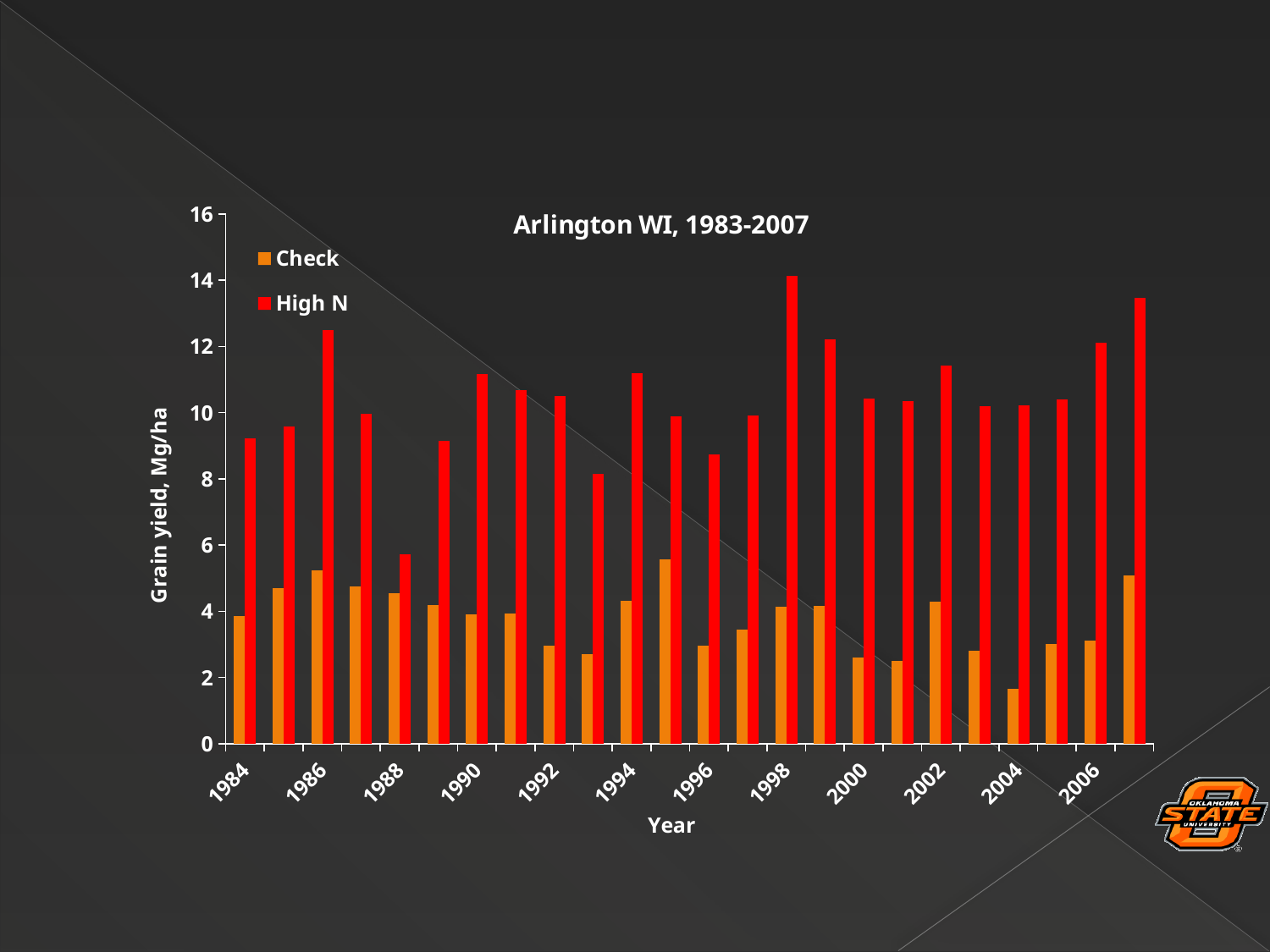
What is the label on the vertical axis? Grain yield, Mg/ha Is the Check value for 2004 greater or less than 2? less In which year is the High N bar the shortest? 1988 Which is larger, the Check value for 1986 or the Check value for 2004? 1986 How many series does the legend list? 2 Which is larger, the High N value for 1986 or the High N value for 1988? 1986 In which year is the Check bar the shortest? 2004 Is the High N value for 1998 greater or less than 12? greater Is the High N value for 1988 greater or less than 6? less What is the title of the chart? Arlington WI, 1983-2007 In which year is the High N bar the tallest? 1998 What kind of chart is shown on the slide? bar chart